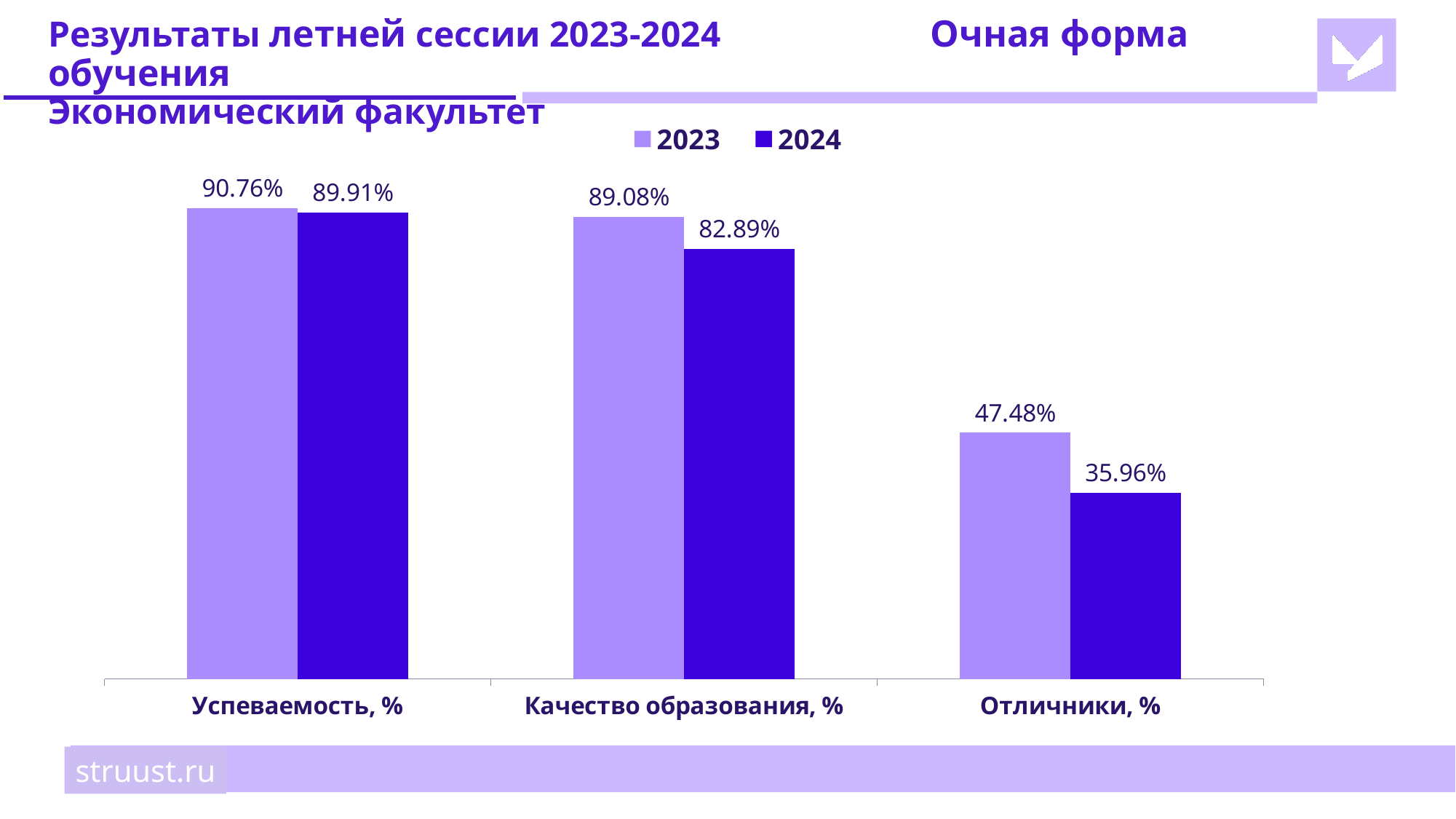
What is the 2024 value for Качество образования, %? 82.89% What kind of chart is shown on the slide? Bar chart What is the 2024 value for Отличники, %? 35.96% What is the difference between the 2023 and 2024 values for Отличники, %? 11.52% How many categories are shown on the x axis? 3 Which is larger for Качество образования, %: the 2023 value or the 2024 value? 2023 What is the difference between the 2023 and 2024 values for Качество образования, %? 6.19% How many series does the legend list? 2 What is the 2023 value for Успеваемость, %? 90.76% What is the 2023 value for Отличники, %? 47.48% Which category has the highest 2023 value? Успеваемость, % Which category has the lowest 2024 value? Отличники, %